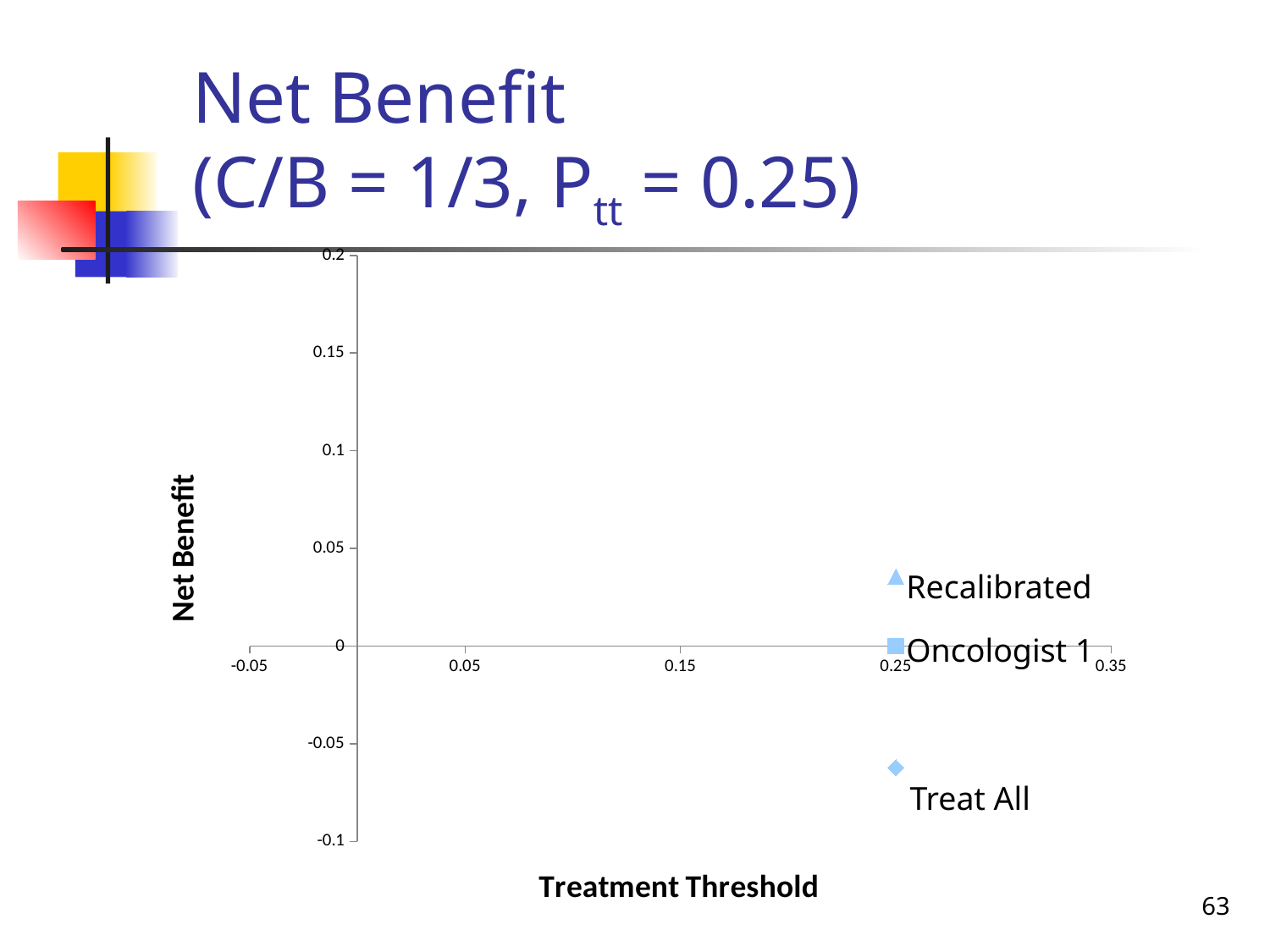
What is the title of the horizontal axis? Treatment Threshold Which has a larger net benefit, Oncologist 1 or Treat All? Oncologist 1 Is the net benefit for Treat All greater or less than -0.05? less How many data points are plotted on the chart? 3 What is the net benefit for Oncologist 1? 0 Which labelled point has the lowest net benefit? Treat All Is the net benefit for Recalibrated greater or less than 0.05? less Is the net benefit for Treat All greater or less than -0.1? greater Which has a larger net benefit, Recalibrated or Treat All? Recalibrated What kind of chart is shown on the slide? scatter chart Which labelled point has the highest net benefit? Recalibrated At what treatment threshold are the three points plotted? 0.25